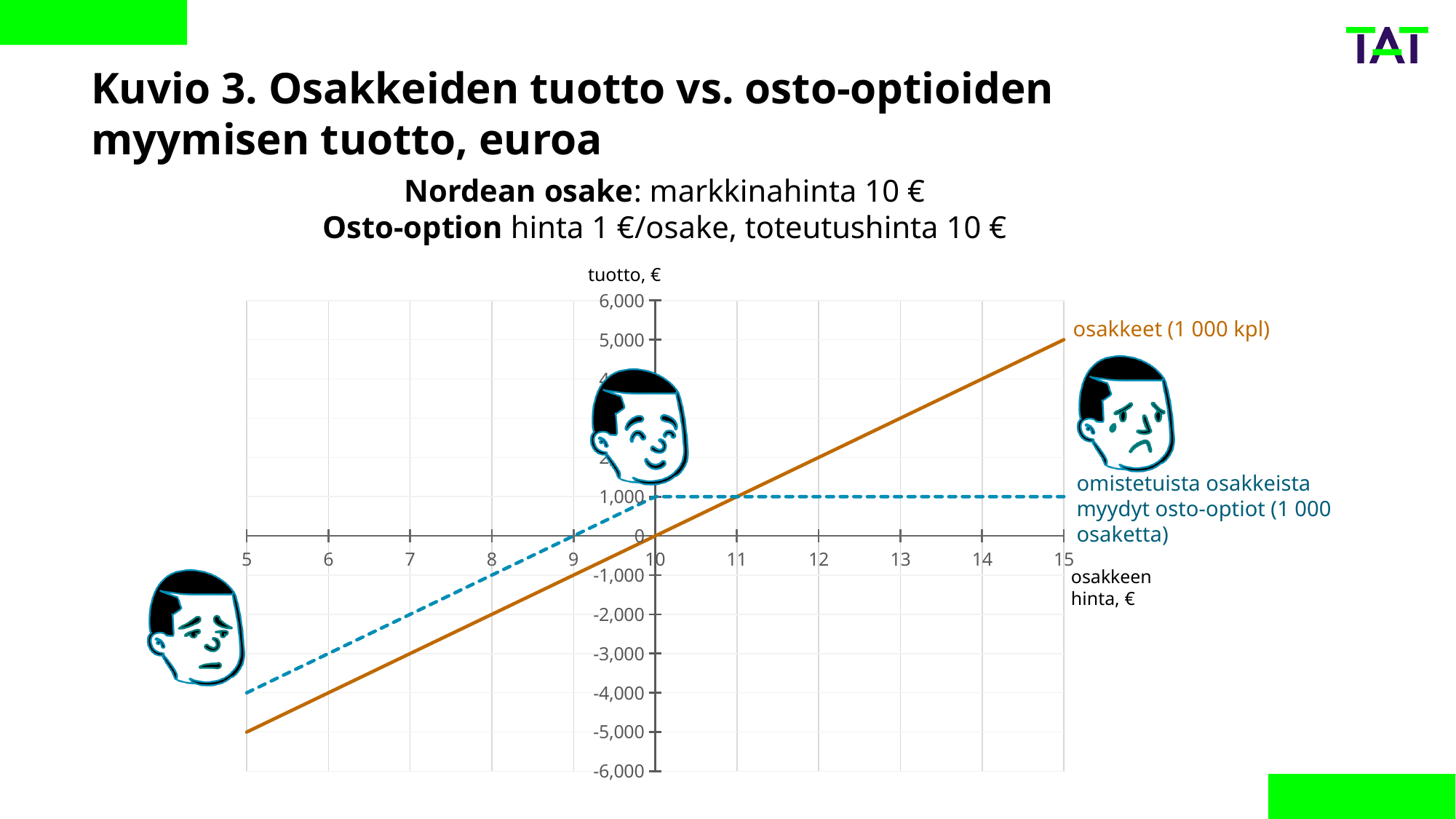
What is the tuotto value of the myydyt osto-optiot line when the osakkeen hinta is 15? 1,000 What kind of chart is shown on the slide? line chart At an osakkeen hinta of 15, what is the difference in tuotto between the osakkeet line and the myydyt osto-optiot line? 4,000 What is the tuotto value of the myydyt osto-optiot line when the osakkeen hinta is 5? -4,000 Does the osakkeet (1 000 kpl) line rise or fall as the osakkeen hinta increases from 5 to 15? rises At an osakkeen hinta of 15, which series has the higher tuotto: osakkeet or myydyt osto-optiot? osakkeet What is the tuotto value of the osakkeet (1 000 kpl) line when the osakkeen hinta is 5? -5,000 What is the tuotto value of the osakkeet (1 000 kpl) line when the osakkeen hinta is 15? 5,000 How many data series are plotted on the chart? 2 At an osakkeen hinta of 5, which series has the higher tuotto: osakkeet or myydyt osto-optiot? myydyt osto-optiot Is the tuotto of the osakkeet (1 000 kpl) line at an osakkeen hinta of 12 greater or less than 1,000? greater What is the tuotto value of the osakkeet (1 000 kpl) line when the osakkeen hinta is 10? 0